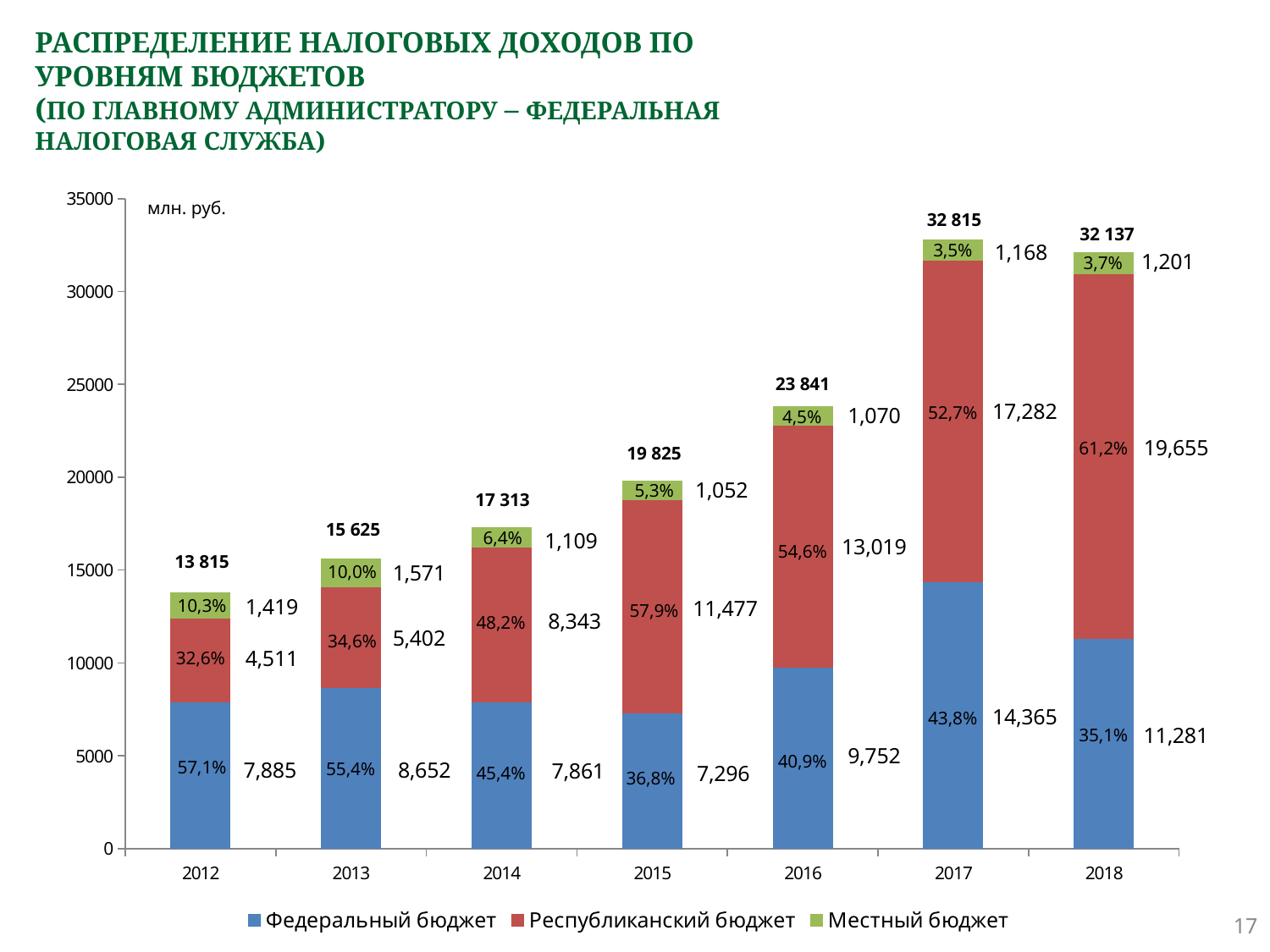
What kind of chart is shown on the slide? Stacked bar chart How many years are shown on the x axis? 7 What is the total of the stacked bar for 2016? 23 841 How many series does the legend list? 3 In which year is the total stacked bar the highest? 2017 Which is larger in 2014: Федеральный бюджет or Республиканский бюджет? Республиканский бюджет What is the value for Федеральный бюджет in 2017? 14,365 What is the value for Местный бюджет in 2013? 1,571 What is the difference between the Республиканский бюджет values in 2018 and 2017? 2,373 What share of the 2015 total does Республиканский бюджет represent, as labelled on the bar? 57,9% What is the value for Республиканский бюджет in 2018? 19,655 In which year is the total stacked bar the lowest? 2012